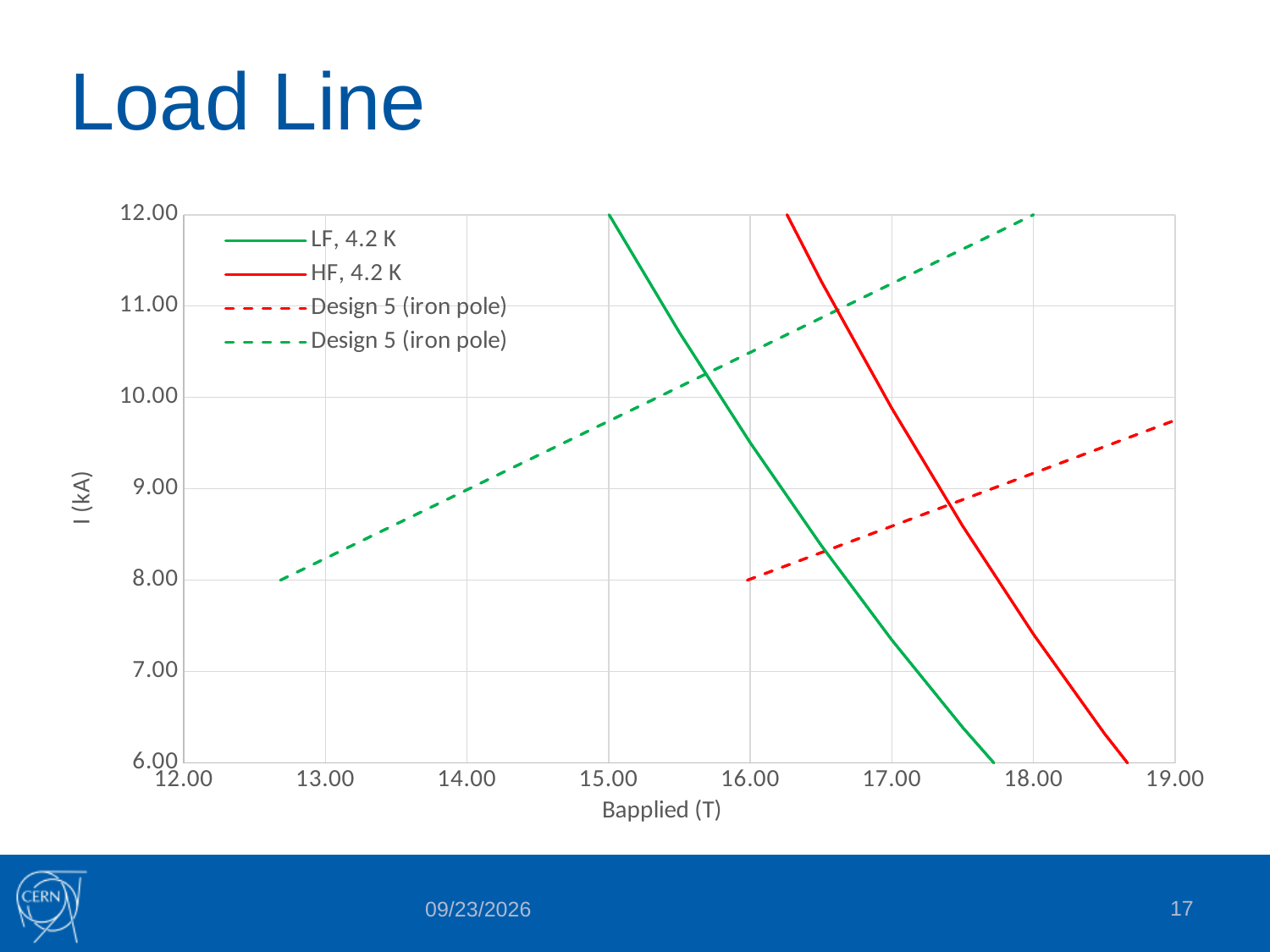
What kind of chart is shown on the slide? line chart How many series does the legend list? 4 At Bapplied = 17.00 T, which solid line has the higher current, LF, 4.2 K or HF, 4.2 K? HF, 4.2 K Is the value of the dashed red Design 5 (iron pole) line at Bapplied = 19.00 T greater or less than 9.00 kA? greater Is the value of the solid green LF, 4.2 K line at Bapplied = 17.00 T greater or less than 8.00 kA? less Is the value of the solid green LF, 4.2 K line at Bapplied = 16.00 T greater or less than 10.00 kA? less What is the title of the chart's y axis? I (kA) Does the dashed green Design 5 (iron pole) line rise or fall as Bapplied increases? rise Does the solid green LF, 4.2 K line rise or fall as Bapplied increases? fall What is the title of the chart's x axis? Bapplied (T)